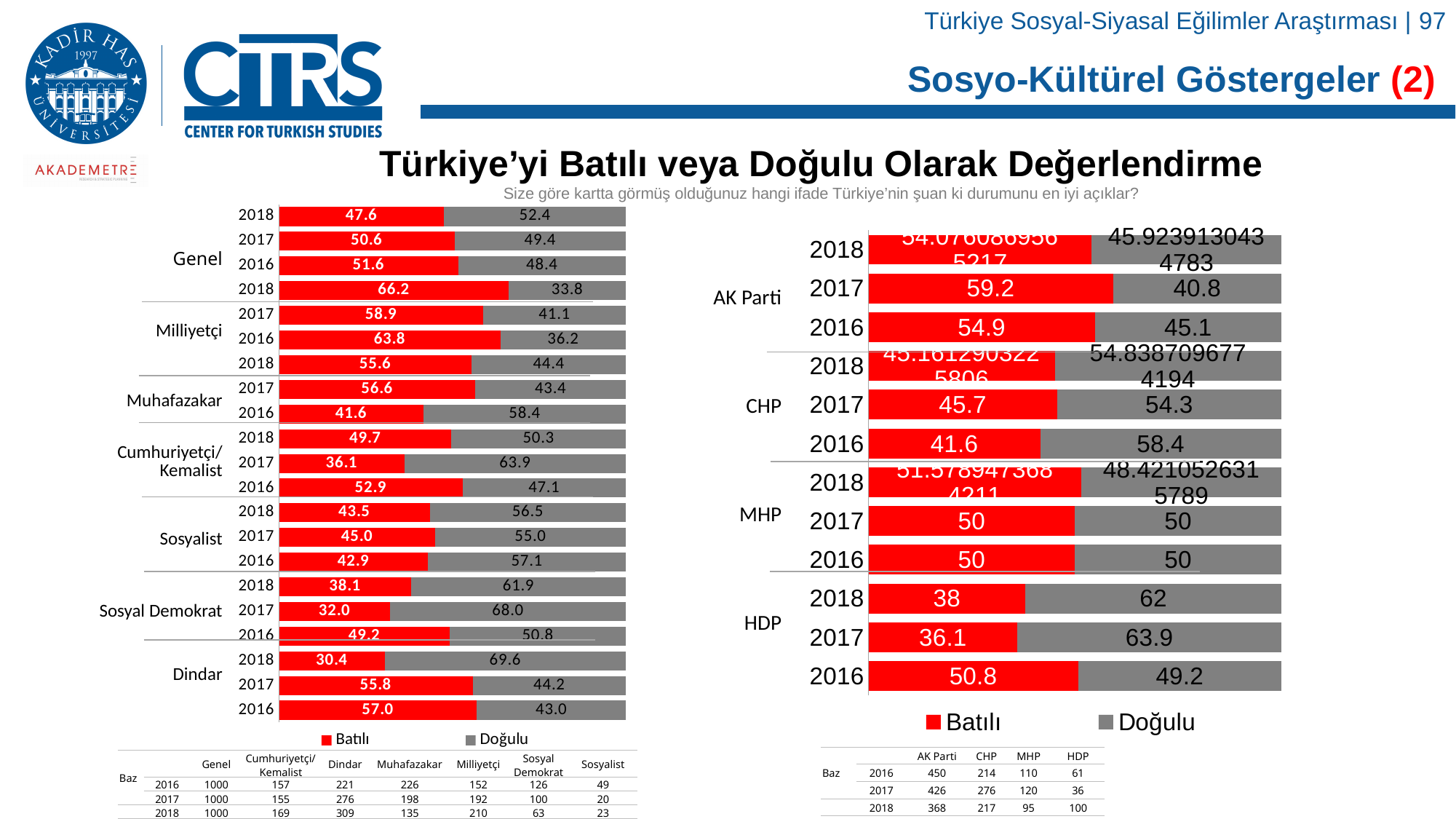
In the left chart, which group and year has the lowest Batılı value? Dindar 2018 In the right chart, what is the difference between the Doğulu and Batılı values for HDP in 2017? 27.8 In the right chart, what is the Doğulu value for HDP in 2017? 63.9 In the right chart, which is larger: the Batılı value for AK Parti in 2017 or for CHP in 2017? AK Parti 2017 In the right chart, what is the Batılı value for MHP in 2017? 50 In the left chart, what is the Batılı value for Milliyetçi in 2018? 66.2 In the left chart, what is the difference between the Batılı values for Dindar in 2017 and 2018? 25.4 What kind of chart is the right chart? stacked bar chart In the left chart, does the Batılı value for Genel rise or fall from 2016 to 2018? falls In the left chart, which group and year has the highest Batılı value? Milliyetçi 2018 In the left chart, what colour represents Batılı? red How many series does the legend of the left chart list? 2